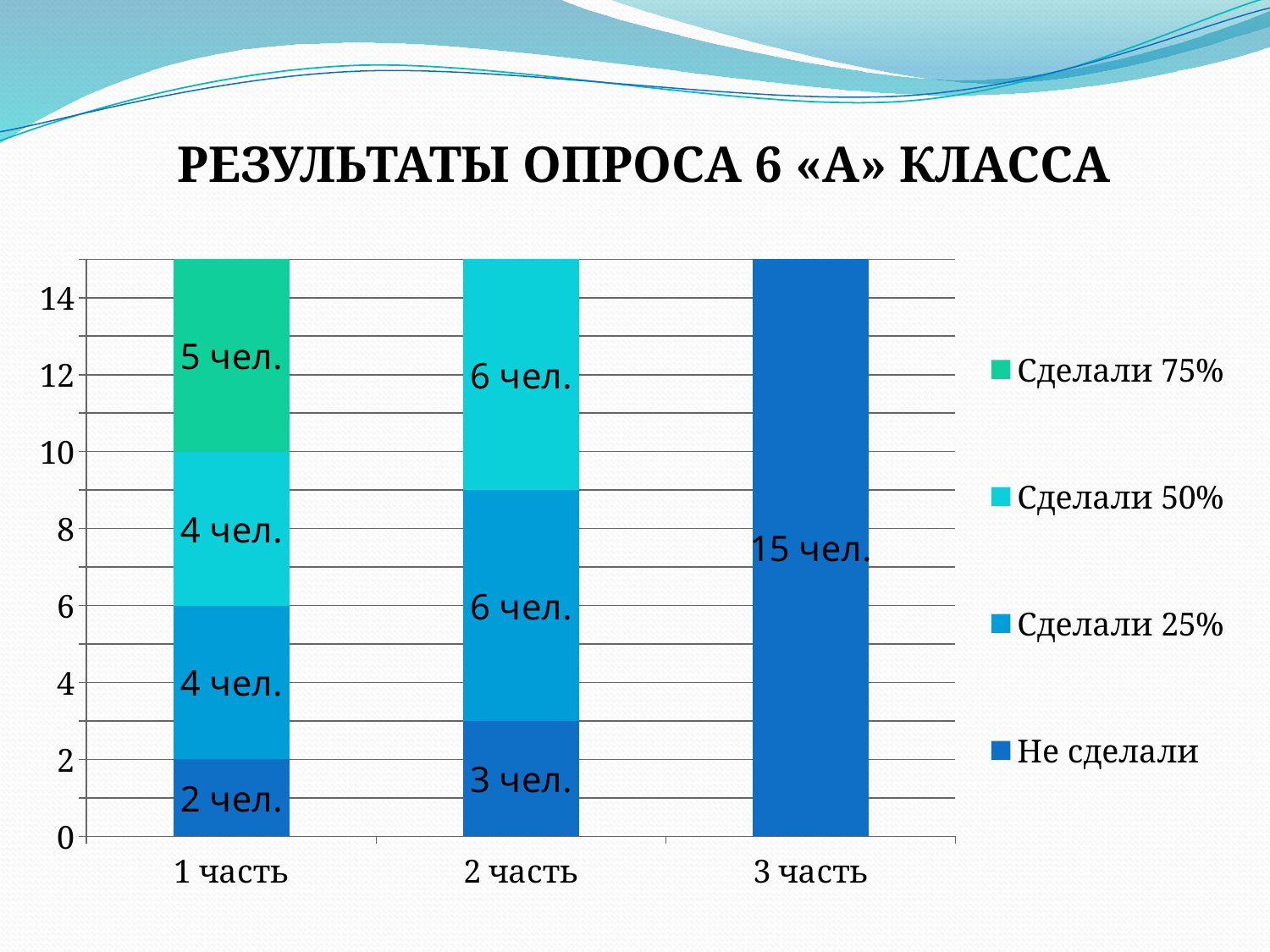
What is the difference between «Сделали 25%» in «2 часть» and «Сделали 25%» in «1 часть»? 2 чел. How many series does the legend list? 4 What is the title of the chart on the slide? РЕЗУЛЬТАТЫ ОПРОСА 6 «А» КЛАССА What is the value for «Не сделали» in «1 часть»? 2 чел. Which category has the lowest value for «Не сделали»? 1 часть Which category has the highest value for «Не сделали»? 3 часть What is the value for «Не сделали» in «2 часть»? 3 чел. How many categories are shown on the x axis? 3 What is the total of the stacked bar for «1 часть»? 15 чел. What is the value for «Сделали 75%» in «1 часть»? 5 чел. What is the value for «Не сделали» in «3 часть»? 15 чел. What kind of chart is shown on the slide? Stacked bar chart